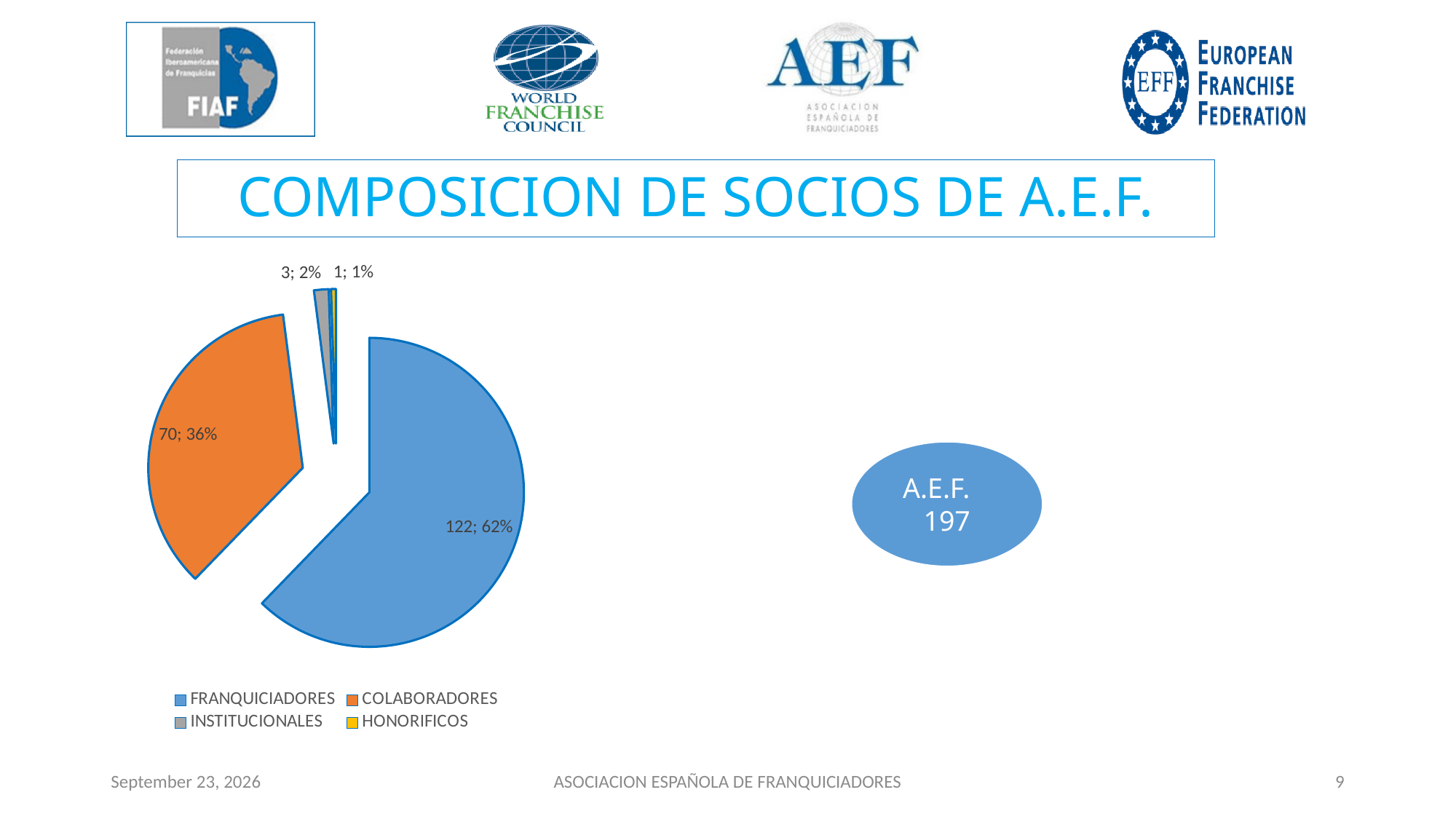
What is the value for COLABORADORES? 70 What colour is the COLABORADORES slice? orange What is the value for INSTITUCIONALES? 3 What share of the pie does COLABORADORES represent? 36% What type of chart is shown on the slide? pie chart Which category has the smallest slice? HONORIFICOS What is the difference between the values for FRANQUICIADORES and COLABORADORES? 52 What is the value for FRANQUICIADORES? 122 How many categories does the pie chart show? 4 What is the value for HONORIFICOS? 1 Which is larger, INSTITUCIONALES or HONORIFICOS? INSTITUCIONALES Which category has the largest slice? FRANQUICIADORES